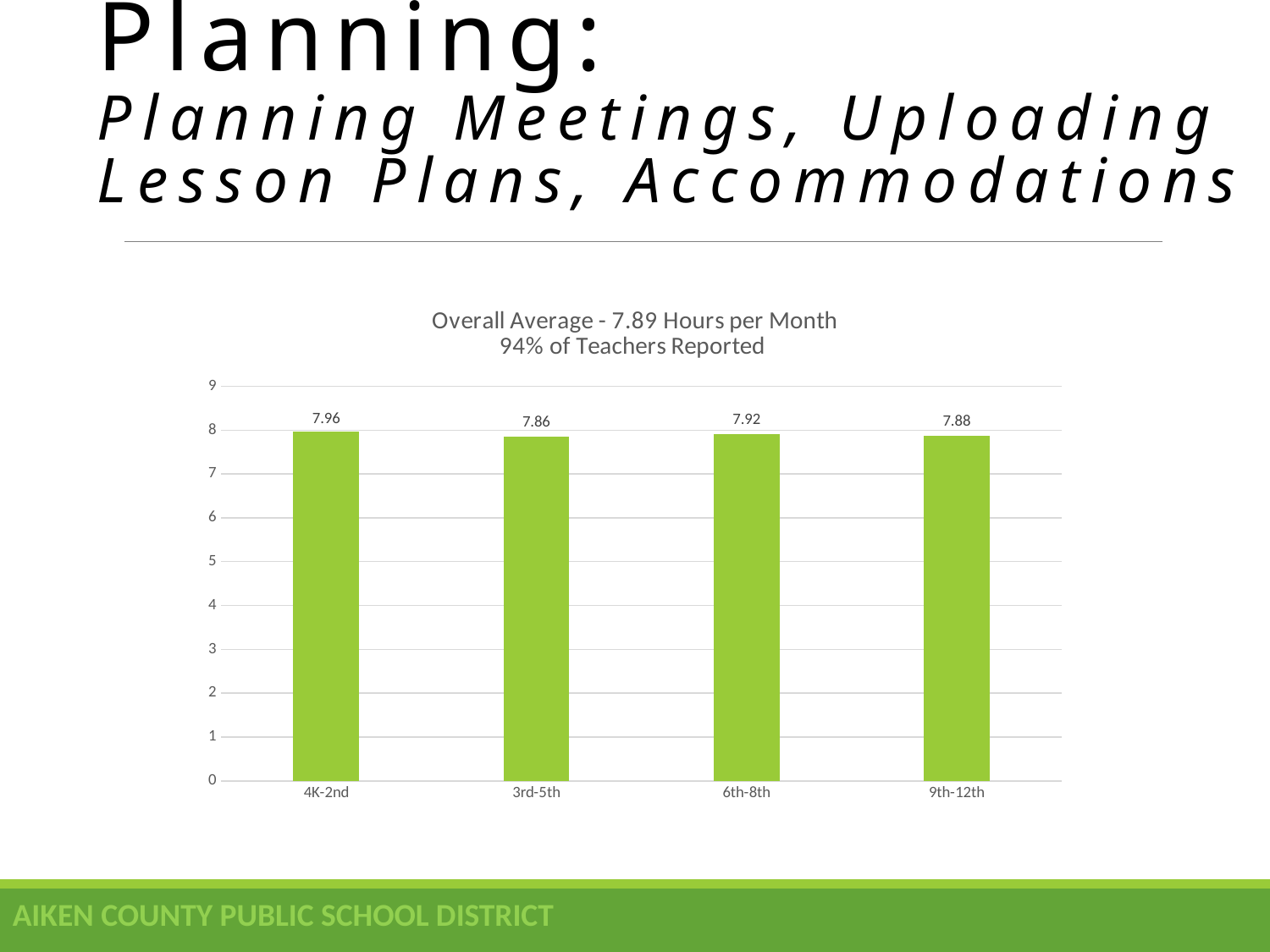
What is the value for 6th-8th? 7.92 What is the value for 9th-12th? 7.88 What is the difference between the values for 6th-8th and 9th-12th? 0.04 What is the value for 3rd-5th? 7.86 How many grade bands are shown on the chart? 4 Which grade band has the highest value? 4K-2nd What is the difference between the values for 4K-2nd and 3rd-5th? 0.10 What overall average is stated in the chart title? 7.89 Hours per Month Which grade band has the lowest value? 3rd-5th Which has a larger value, 6th-8th or 9th-12th? 6th-8th What is the value for 4K-2nd? 7.96 What kind of chart is shown on the slide? Bar chart